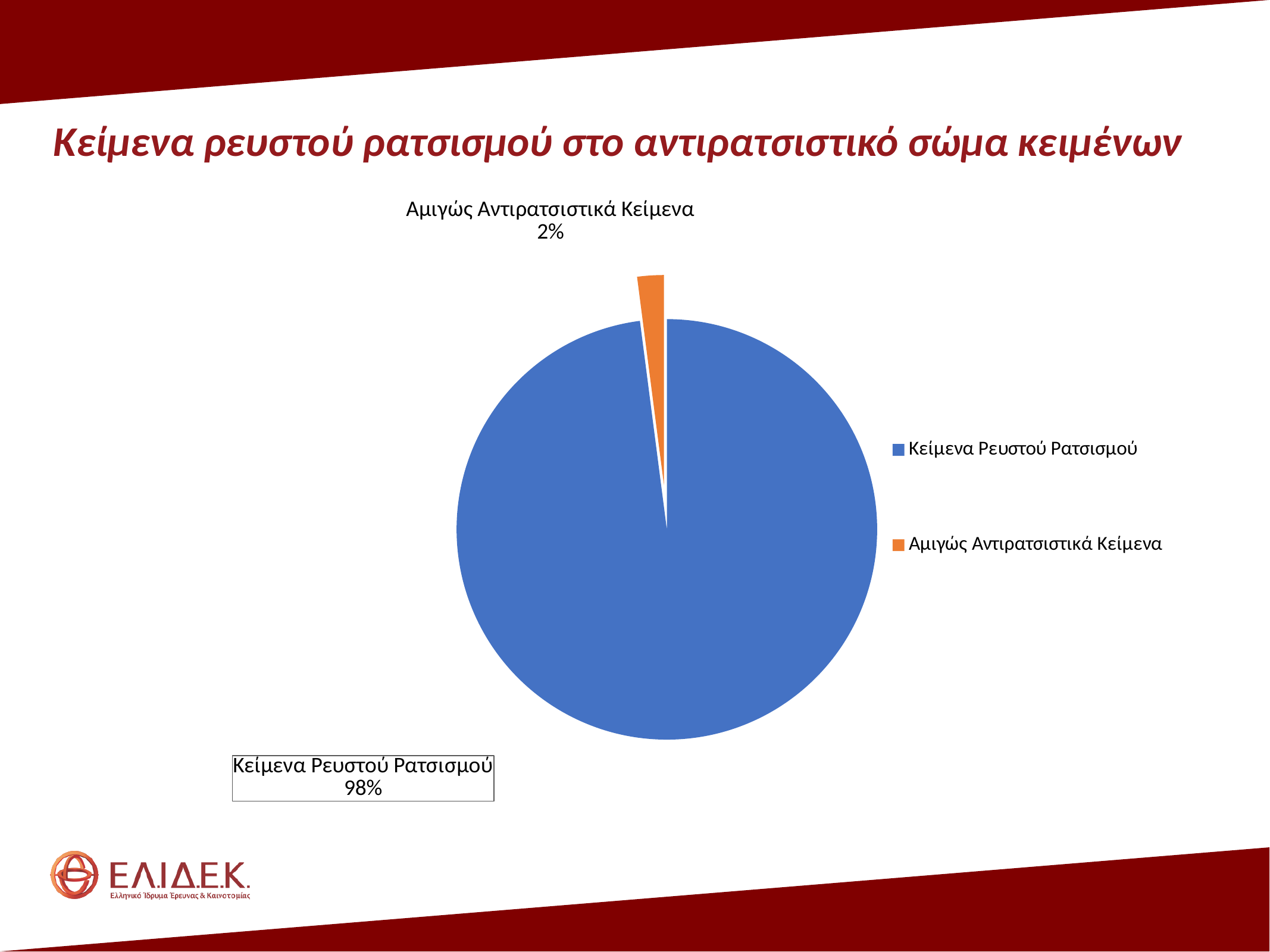
What kind of chart is shown on the slide? Pie chart Which category has the smallest slice of the pie? Αμιγώς Αντιρατσιστικά Κείμενα How many categories does the pie chart show? 2 Which is larger, the slice for Κείμενα Ρευστού Ρατσισμού or the slice for Αμιγώς Αντιρατσιστικά Κείμενα? Κείμενα Ρευστού Ρατσισμού What colour is the slice for Αμιγώς Αντιρατσιστικά Κείμενα? Orange What share of the pie does Αμιγώς Αντιρατσιστικά Κείμενα represent? 2% Which category has the largest slice of the pie? Κείμενα Ρευστού Ρατσισμού What is the title of the slide containing the pie chart? Κείμενα ρευστού ρατσισμού στο αντιρατσιστικό σώμα κειμένων How many entries does the legend list? 2 What is the difference in percentage points between Κείμενα Ρευστού Ρατσισμού and Αμιγώς Αντιρατσιστικά Κείμενα? 96 percentage points What share of the pie does Κείμενα Ρευστού Ρατσισμού represent? 98%